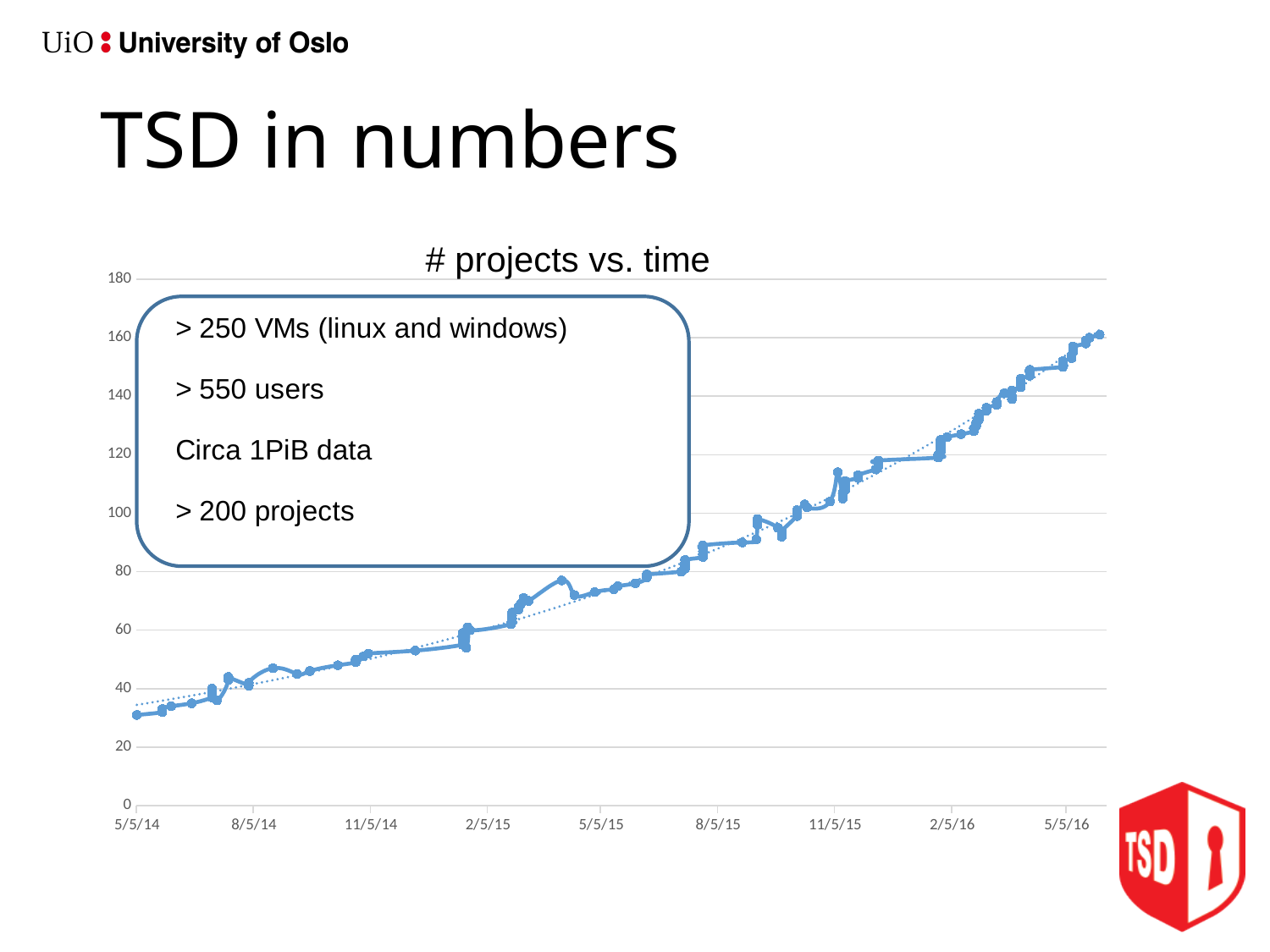
What is the title of the chart? # projects vs. time Do the values in the chart generally rise or fall over time along the x axis? rise Is the value at 8/5/15 greater or less than 60? greater Is the value at 5/5/16 greater or less than 140? greater Which is larger, the value at 8/5/14 or the value at 11/5/15? 11/5/15 Is the value at 5/5/14 greater or less than 40? less Which is larger, the value at 5/5/15 or the value at 2/5/16? 2/5/16 What kind of chart is shown on the slide? line chart What is the highest value shown on the y axis? 180